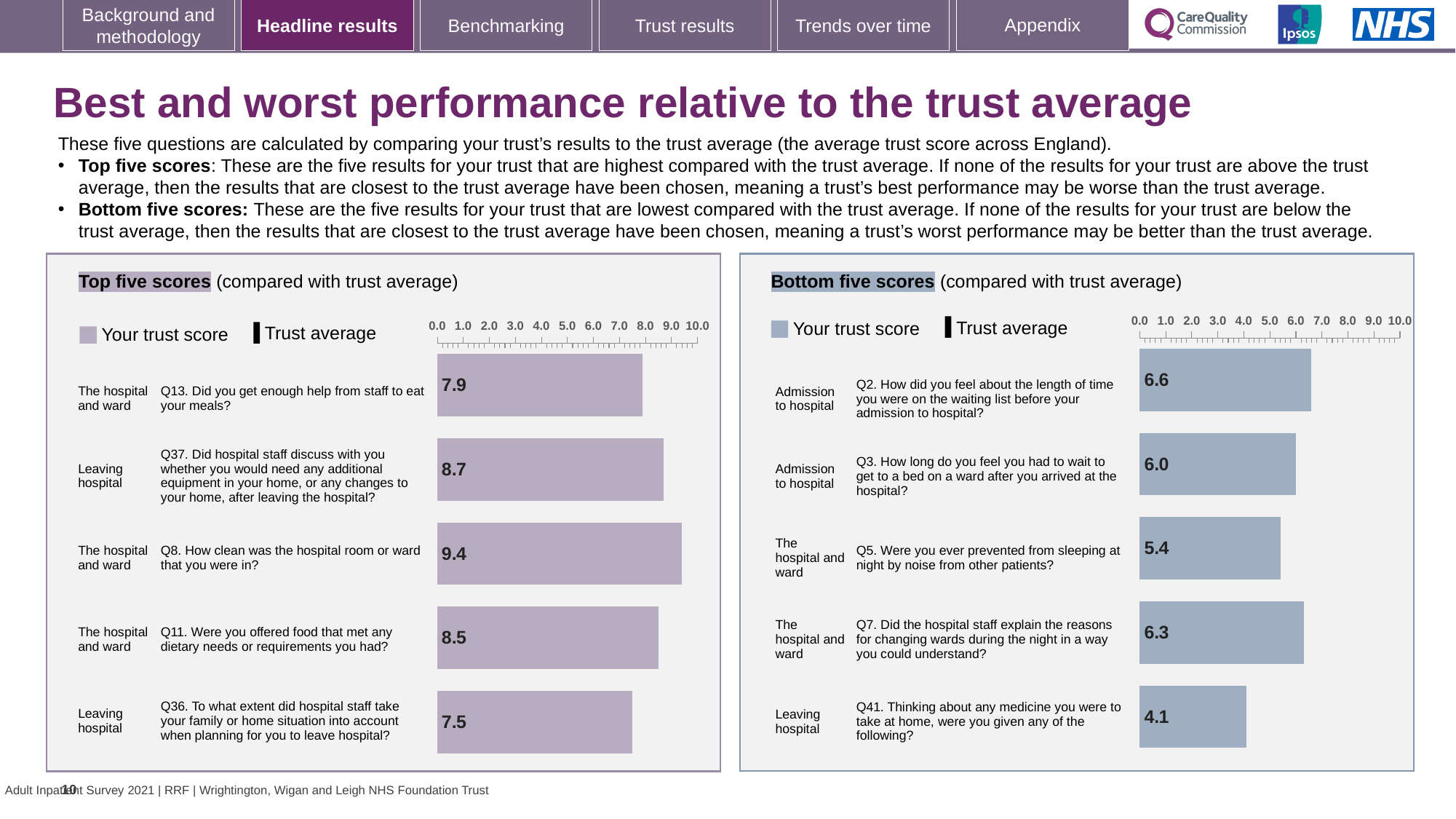
In the Bottom five scores chart, what is the difference between the trust scores for Q2 and Q41? 2.5 How many questions are shown in the Bottom five scores chart? 5 In the Bottom five scores chart, what is the trust score for Q41 (Thinking about any medicine you were to take at home, were you given any of the following?)? 4.1 In the Bottom five scores chart, what is the trust score for Q3 (How long do you feel you had to wait to get to a bed on a ward after you arrived at the hospital?)? 6.0 In the Bottom five scores chart, which question has the lowest trust score? Q41. Thinking about any medicine you were to take at home, were you given any of the following? What kind of chart is the Top five scores chart? Bar chart How many series does the legend of the Top five scores chart list? 2 In the Top five scores chart, what is the trust score for Q36 (To what extent did hospital staff take your family or home situation into account when planning for you to leave hospital?)? 7.5 In the Bottom five scores chart, which has the larger trust score, Q2 or Q7? Q2 In the Top five scores chart, which question has the highest trust score? Q8. How clean was the hospital room or ward that you were in? In the Top five scores chart, what is the difference between the trust scores for Q8 and Q36? 1.9 In the Top five scores chart, what is the trust score for Q8 (How clean was the hospital room or ward that you were in?)? 9.4